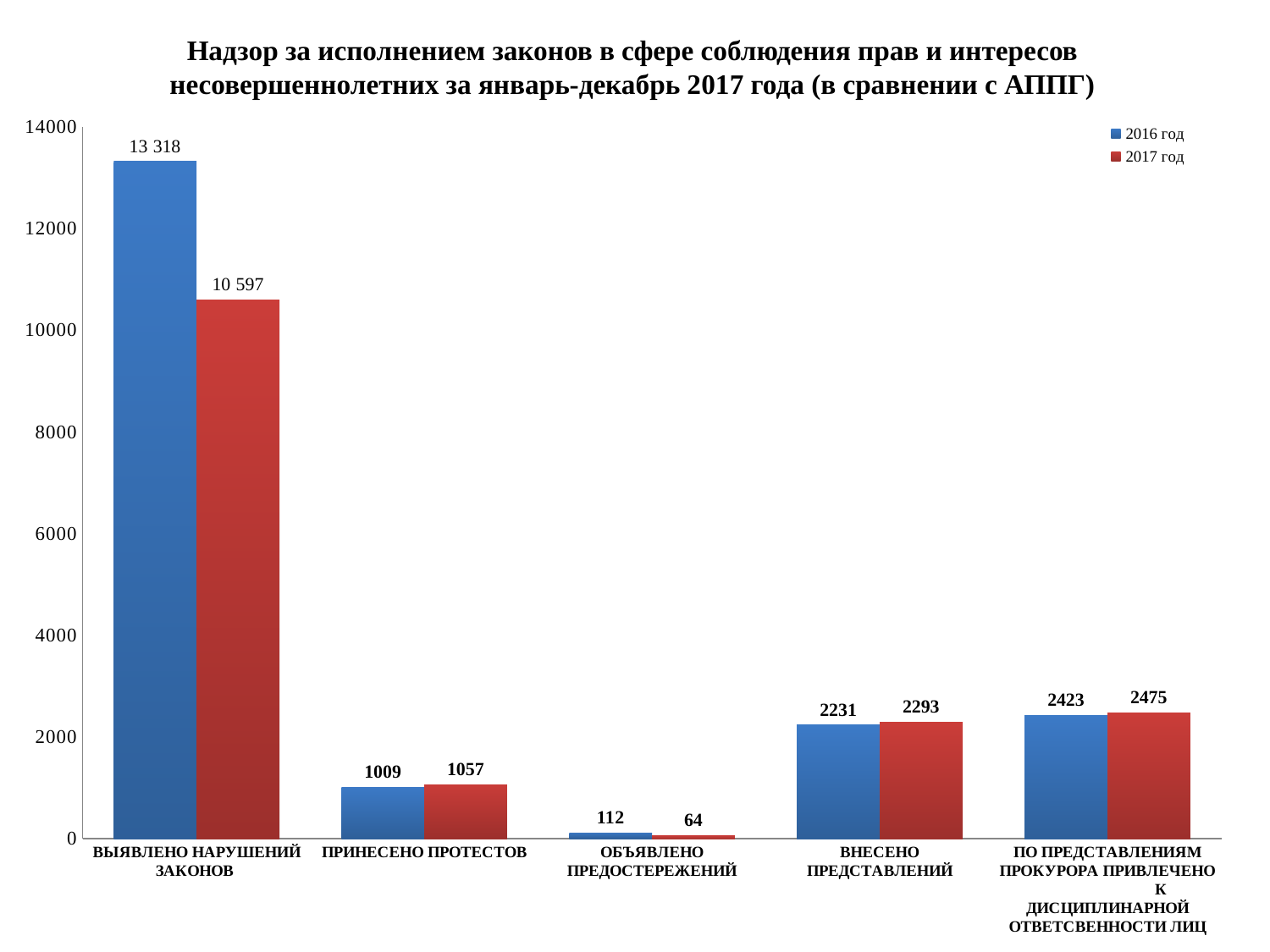
Which category has the highest value for 2016 год? ВЫЯВЛЕНО НАРУШЕНИЙ ЗАКОНОВ What is the value for 2016 год in the category ВЫЯВЛЕНО НАРУШЕНИЙ ЗАКОНОВ? 13 318 What is the value for 2017 год in the category ПРИНЕСЕНО ПРОТЕСТОВ? 1057 What is the difference between the 2016 год and 2017 год values for ВНЕСЕНО ПРЕДСТАВЛЕНИЙ? 62 How many series does the legend list? 2 What is the difference between the 2016 год and 2017 год values for ОБЪЯВЛЕНО ПРЕДОСТЕРЕЖЕНИЙ? 48 What is the value for 2016 год in the category ОБЪЯВЛЕНО ПРЕДОСТЕРЕЖЕНИЙ? 112 What is the value for 2017 год in the category ВЫЯВЛЕНО НАРУШЕНИЙ ЗАКОНОВ? 10 597 Which is larger for ВЫЯВЛЕНО НАРУШЕНИЙ ЗАКОНОВ: the 2016 год value or the 2017 год value? 2016 год What kind of chart is shown on the slide? Bar chart Which category has the lowest value for 2017 год? ОБЪЯВЛЕНО ПРЕДОСТЕРЕЖЕНИЙ How many categories are shown on the x axis? 5